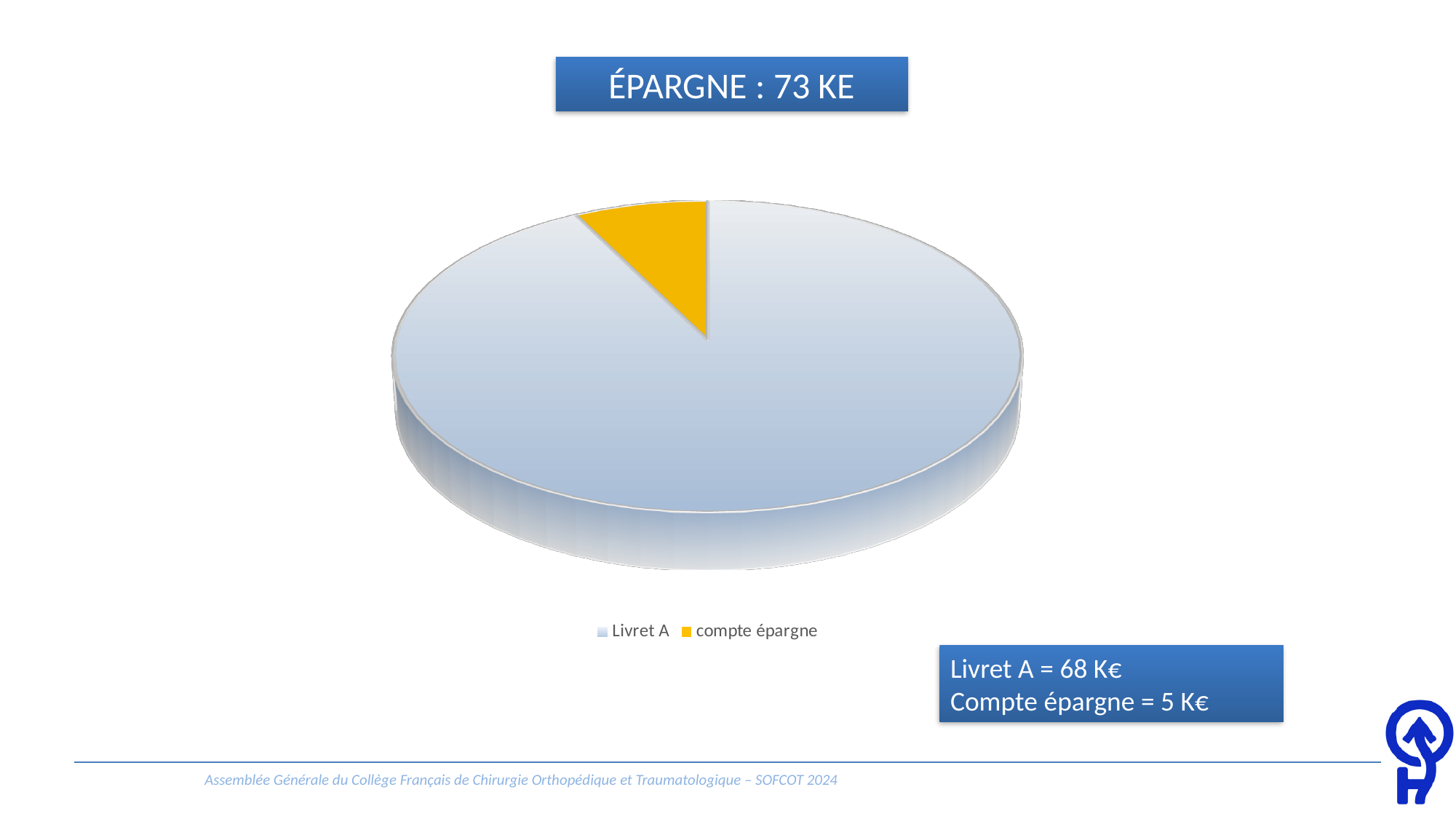
What kind of chart is shown on the slide? pie chart What colour is the compte épargne slice? yellow Which is larger, Livret A or Compte épargne? Livret A Which category has the largest slice of the pie? Livret A What is the title of the chart? ÉPARGNE : 73 KE What is the value for Livret A? 68 K€ What is the total savings amount shown in the chart title? 73 KE How many slices does the pie chart have? 2 How many entries does the legend list? 2 What is the difference between the Livret A value and the Compte épargne value? 63 K€ Which category has the smallest slice of the pie? compte épargne What is the value for Compte épargne? 5 K€